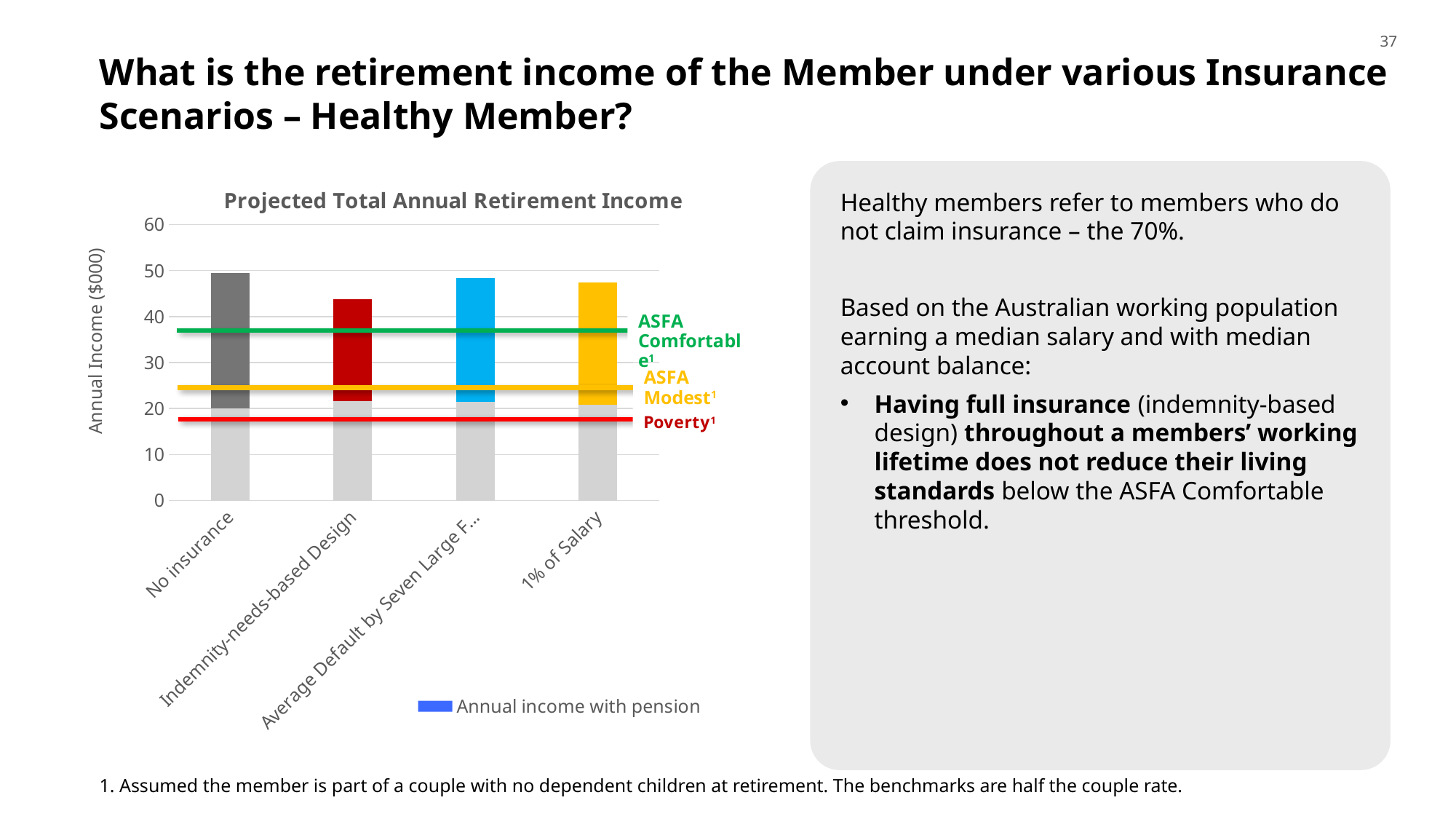
What kind of chart is shown on the slide? Bar chart Is the ASFA Comfortable reference line greater or less than 40? less How many series does the chart legend list? 1 What is the title of the chart? Projected Total Annual Retirement Income Is the value for Indemnity-needs-based Design greater or less than 50? less Which is larger, the value for No insurance or the value for Indemnity-needs-based Design? No insurance How many insurance scenario categories are plotted on the x axis? 4 Is the value for No insurance greater or less than 40? greater What is the legend entry for the bars? Annual income with pension Which scenario has the lowest projected annual retirement income? Indemnity-needs-based Design